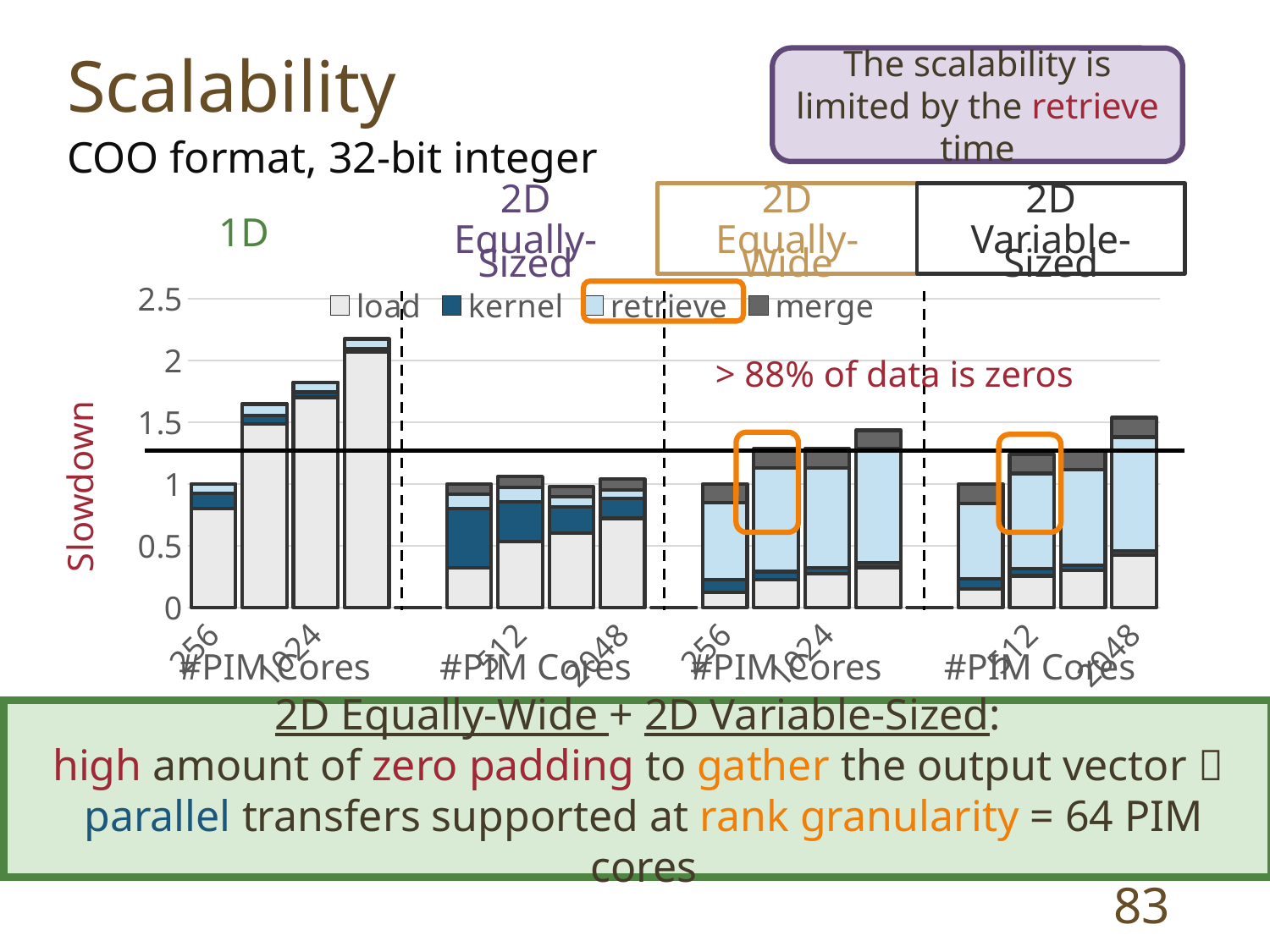
Is the total of the rightmost bar in the 2D Equally-Wide group greater or less than 1? greater Do the stacked bar totals rise or fall from left to right within the 1D group? rise What is the title of the vertical axis of the chart? Slowdown How many bars are plotted in the 1D group of the chart? 4 Is the total of the second bar in the 1D group greater or less than 1.5? greater What are the four series named in the chart legend? load, kernel, retrieve, merge What kind of chart is shown on the slide? stacked bar chart Is the total of the rightmost bar in the 2D Equally-Wide group greater or less than 1.5? less How many groups of bars (partitioning schemes) does the chart show? 4 How many series does the chart legend list? 4 Which group contains the tallest stacked bar in the chart? 1D